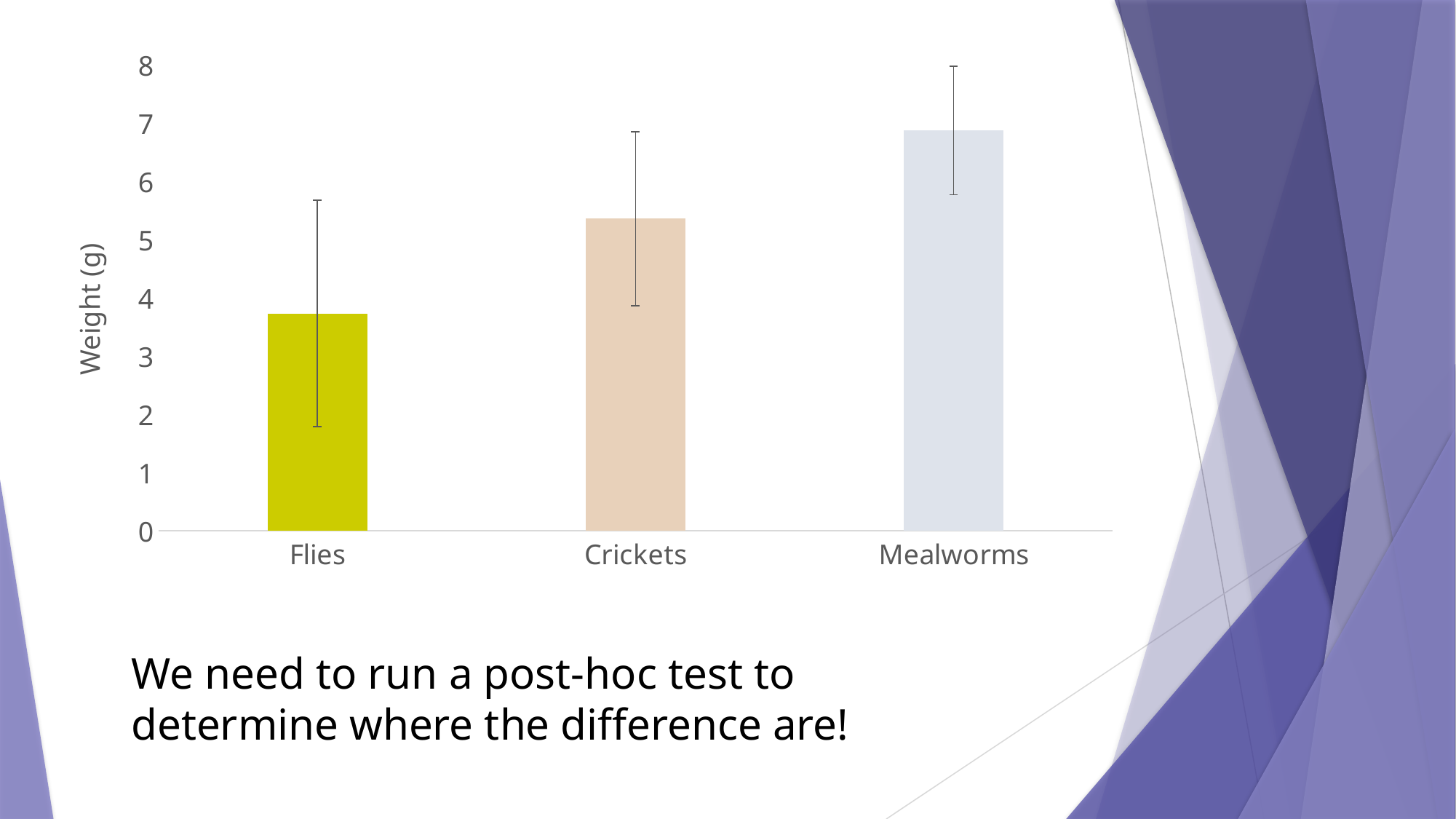
Which category has the highest weight in the chart? Mealworms Do the bar values rise or fall from Flies to Mealworms along the x axis? rise What is the label on the y axis of the chart? Weight (g) Is the value for Crickets greater or less than 5? greater Which has the larger weight, Mealworms or Crickets? Mealworms How many categories are plotted on the x axis of the chart? 3 What colour is the bar for Flies? yellow-green Which category has the lowest weight in the chart? Flies What kind of chart is shown on the slide? bar chart Is the value for Flies greater or less than 5? less Is the value for Mealworms greater or less than 6? greater Which has the larger weight, Crickets or Flies? Crickets